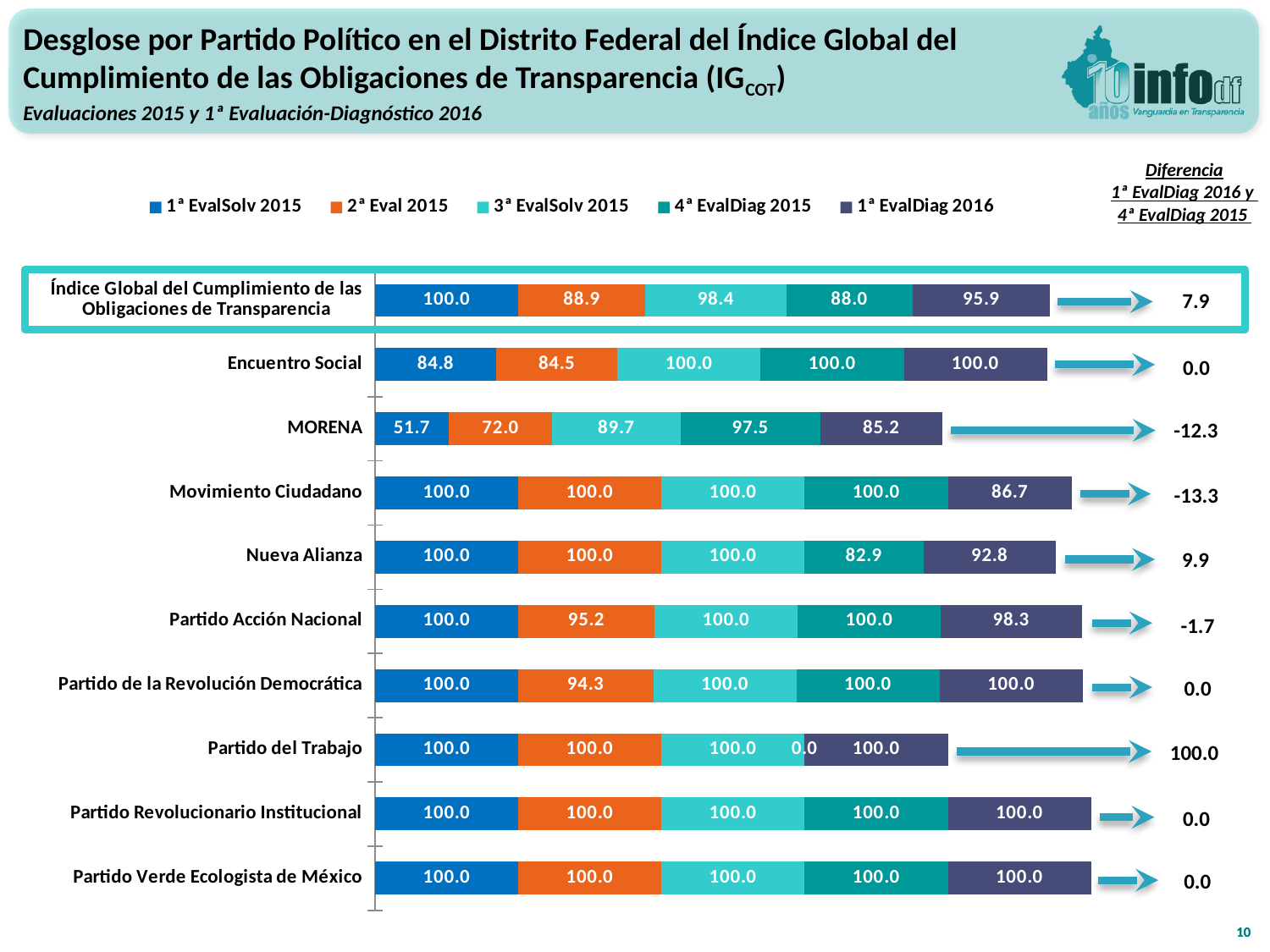
What 'Diferencia' value is shown to the right of the bar for Partido del Trabajo? 100.0 What is the 4ª EvalDiag 2015 value for Nueva Alianza? 82.9 What is the 4ª EvalDiag 2015 value for Partido del Trabajo? 0.0 How many categories (rows) are plotted in the chart? 10 For MORENA, which is larger: the 2ª Eval 2015 value or the 3ª EvalSolv 2015 value? 3ª EvalSolv 2015 Which category has the lowest 1ª EvalSolv 2015 value? MORENA What is the 1ª EvalDiag 2016 value for Movimiento Ciudadano? 86.7 How many series does the legend list? 5 What is the total of the stacked bar for Partido Verde Ecologista de México? 500.0 What is the difference between the 1ª EvalDiag 2016 and 4ª EvalDiag 2015 values for the Índice Global del Cumplimiento de las Obligaciones de Transparencia? 7.9 What kind of chart is shown on the slide? Stacked bar chart What is the 1ª EvalSolv 2015 value for MORENA? 51.7